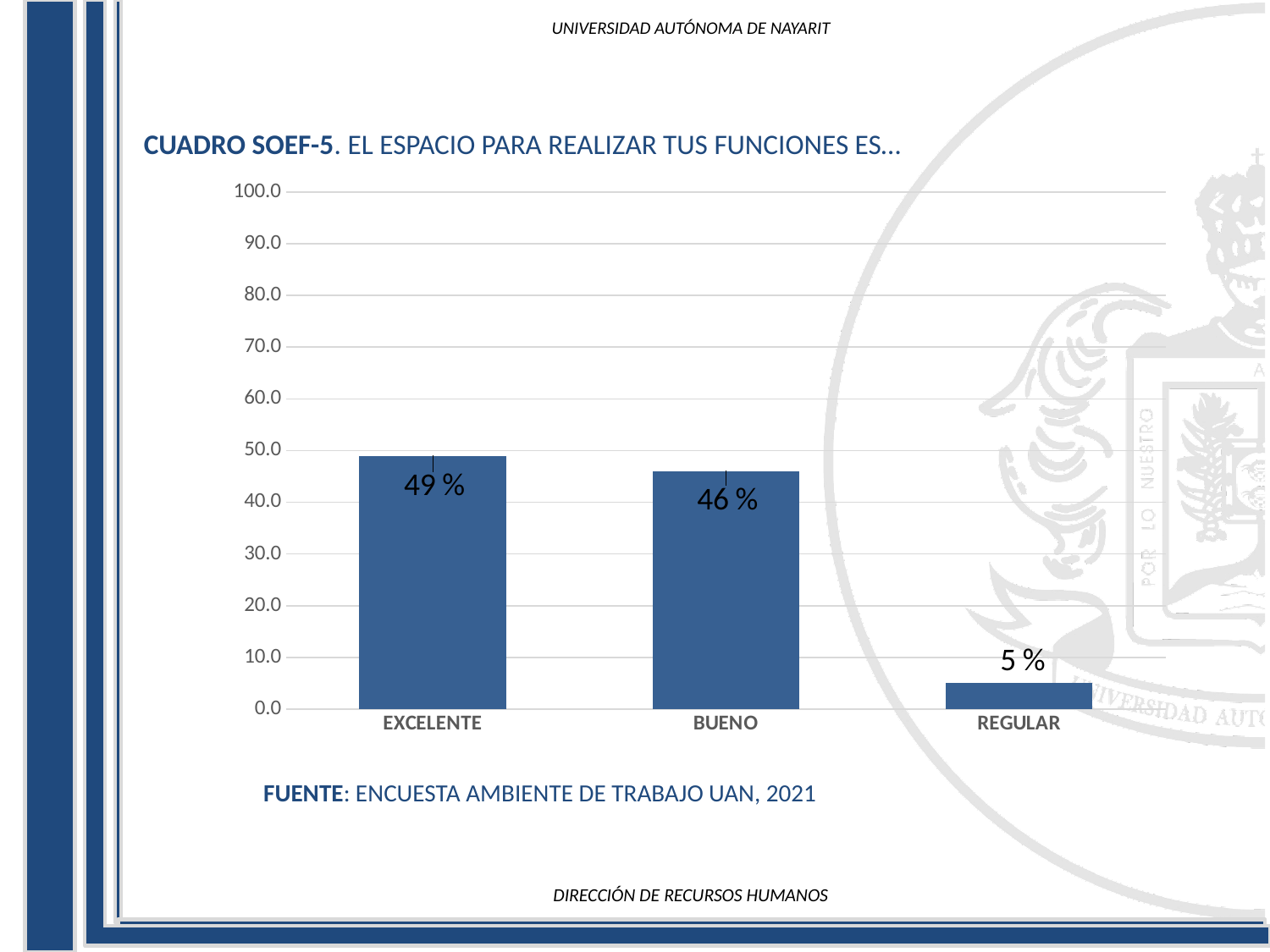
What is the difference between the values for BUENO and REGULAR? 41 % What is the difference between the values for EXCELENTE and BUENO? 3 % Is the value for REGULAR greater or less than 10.0? less What is the source cited below the chart? ENCUESTA AMBIENTE DE TRABAJO UAN, 2021 What is the value for REGULAR? 5 % How many categories are shown on the x axis? 3 Which is larger, the value for BUENO or the value for REGULAR? BUENO What is the value for BUENO? 46 % What kind of chart is shown on the slide? bar chart Which category has the highest value? EXCELENTE What is the value for EXCELENTE? 49 % Which category has the lowest value? REGULAR